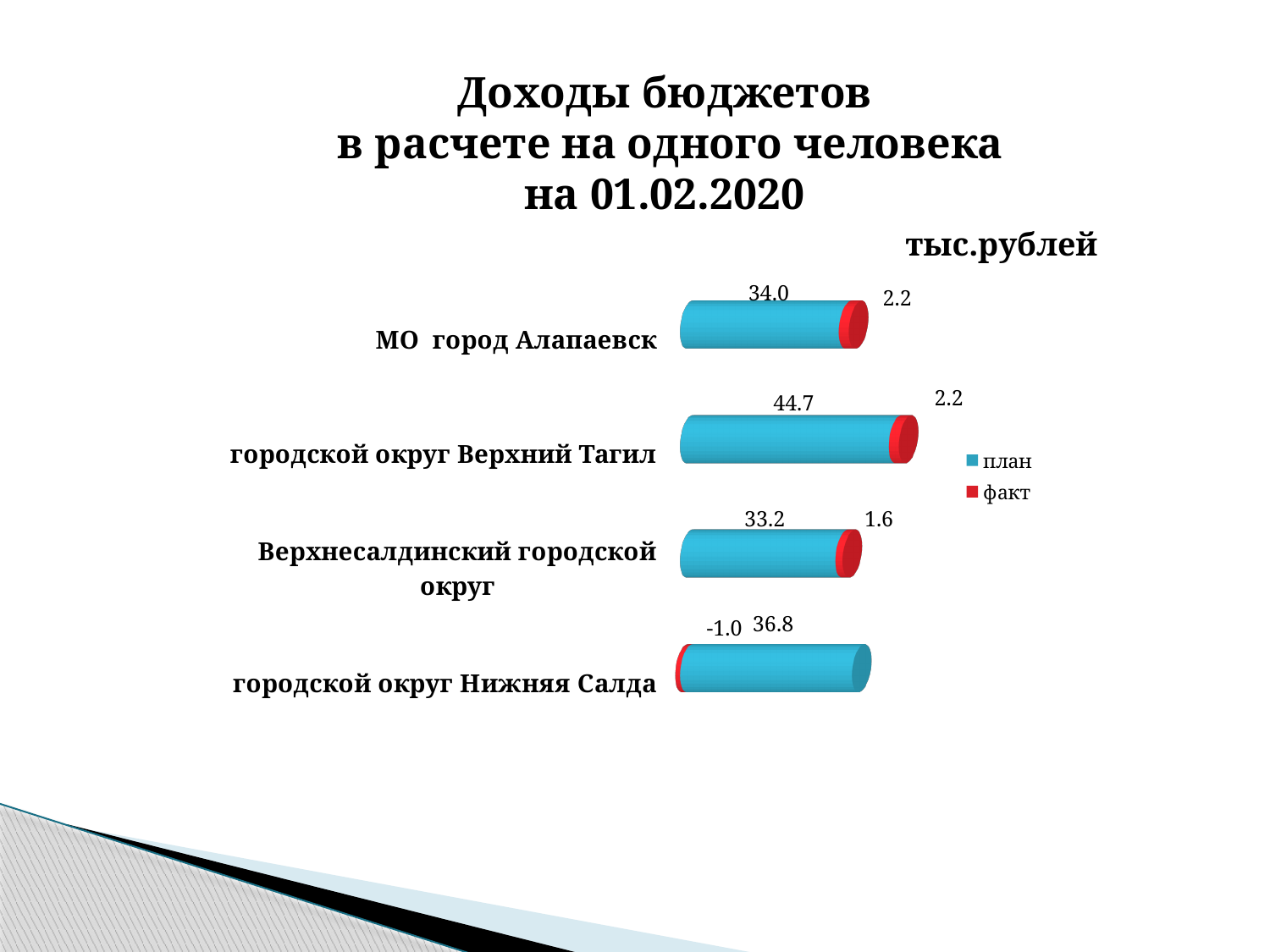
What is the факт value for Верхнесалдинский городской округ? 1.6 How many categories are shown in the chart? 4 What is the difference between the план values for городской округ Верхний Тагил and МО город Алапаевск? 10.7 What is the план value for городской округ Верхний Тагил? 44.7 Which category has the highest план value? городской округ Верхний Тагил Which category has the lowest план value? Верхнесалдинский городской округ What is the план value for МО город Алапаевск? 34.0 What kind of chart is shown on the slide? bar chart Which category has the lowest факт value? городской округ Нижняя Салда What is the факт value for городской округ Нижняя Салда? -1.0 Which is larger: the план value for городской округ Нижняя Салда or for Верхнесалдинский городской округ? городской округ Нижняя Салда How many series does the legend list? 2